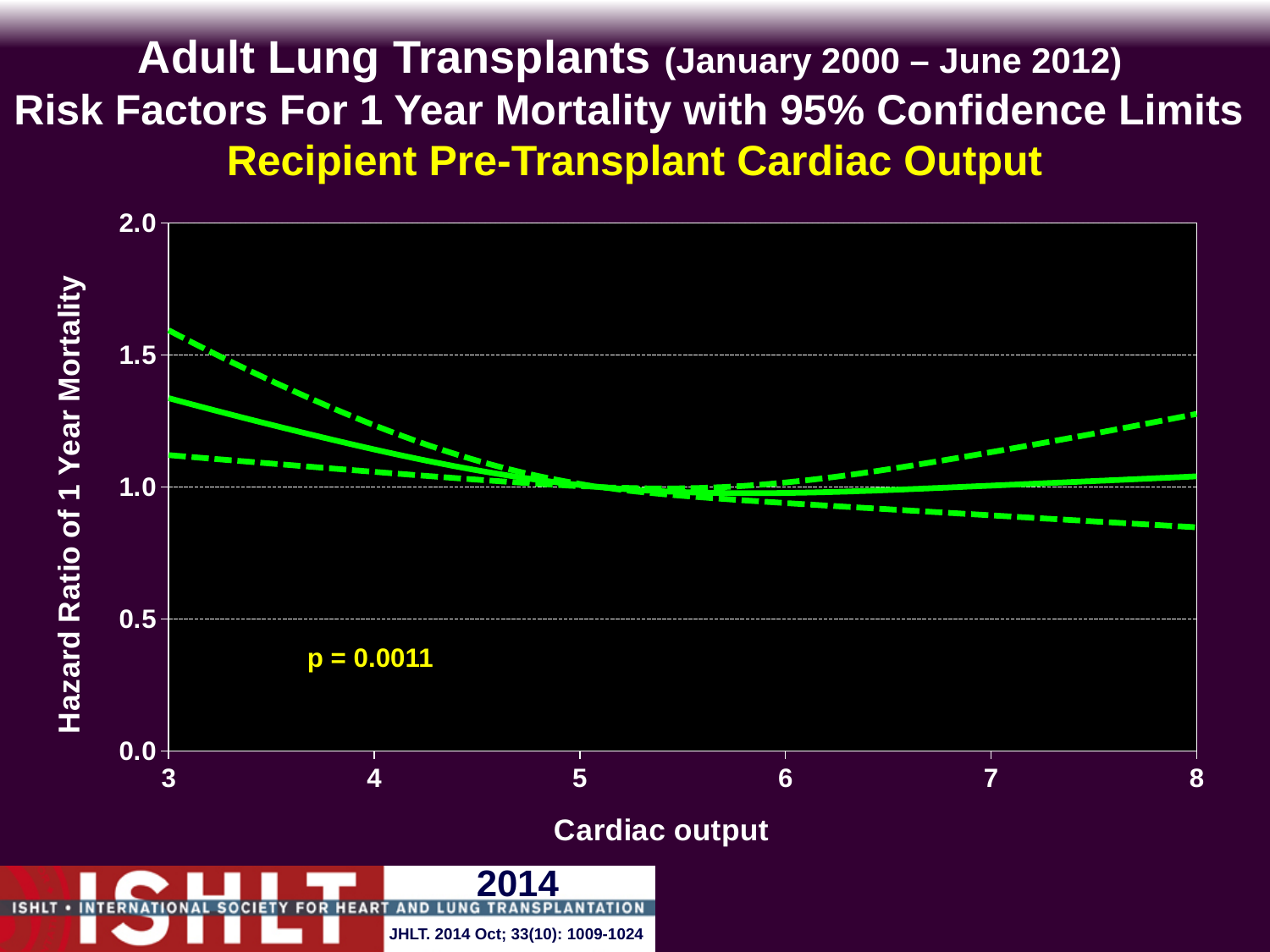
What kind of chart is shown on the slide? Line chart Does the hazard ratio (solid line) rise or fall as cardiac output increases from 3 to 5? fall Does the upper confidence limit (upper dashed line) rise or fall as cardiac output increases from 5 to 8? rise What p-value is printed on the chart? p = 0.0011 Is the upper confidence limit (upper dashed line) at a cardiac output of 3 greater or less than 1.5? greater What is the highest value labelled on the y axis? 2.0 Is the hazard ratio (solid line) at a cardiac output of 3 greater or less than 1.0? greater What is the label of the y axis? Hazard Ratio of 1 Year Mortality Is the lower confidence limit (lower dashed line) at a cardiac output of 8 greater or less than 1.0? less How many tick values are labelled on the x axis? 6 What is the label of the x axis? Cardiac output